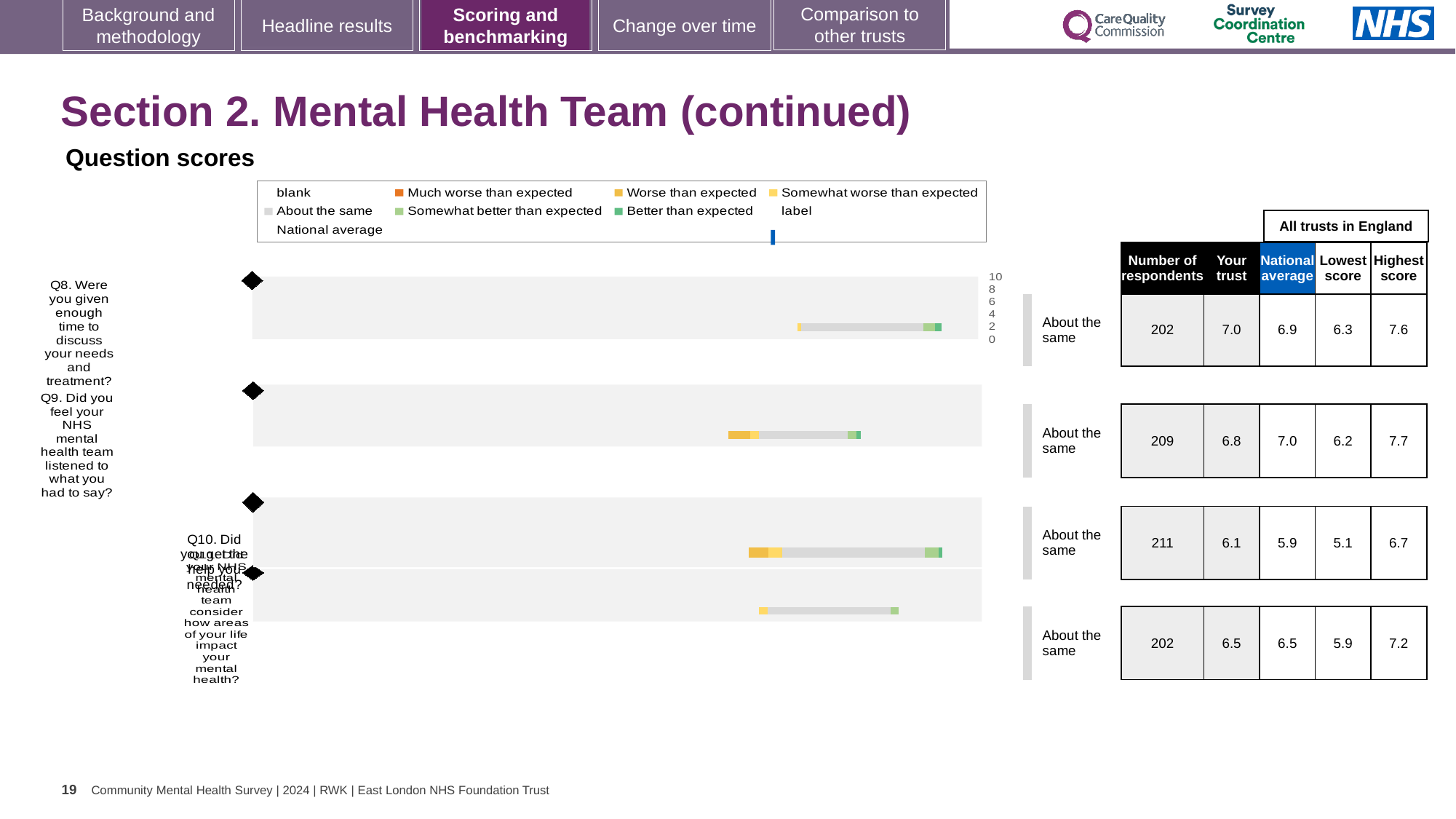
In the table beside the chart, what is the number of respondents for Q9 (Did you feel your NHS mental health team listened to what you had to say?)? 209 Which of Q8, Q9 and Q10 has the largest number of respondents in the table? Q10 In the table, what is the difference between the highest score and the lowest score for Q8? 1.3 What kind of chart is used to show the question scores on this slide? bar chart How many horizontal bars are plotted in the question scores chart? 4 In the chart legend, what colour represents 'Much worse than expected'? orange In the table beside the chart, what is the national average for Q10 (Did you get the help you needed?)? 5.9 Which has the higher 'Your trust' score in the table, Q8 or Q9? Q8 What benchmark label is shown next to the Q10 bar in the chart? About the same In the table beside the chart, what is the 'Your trust' score for Q8 (Were you given enough time to discuss your needs and treatment?)? 7.0 What is the heading printed above the chart? Question scores In the table beside the chart, what is the highest score for Q9? 7.7